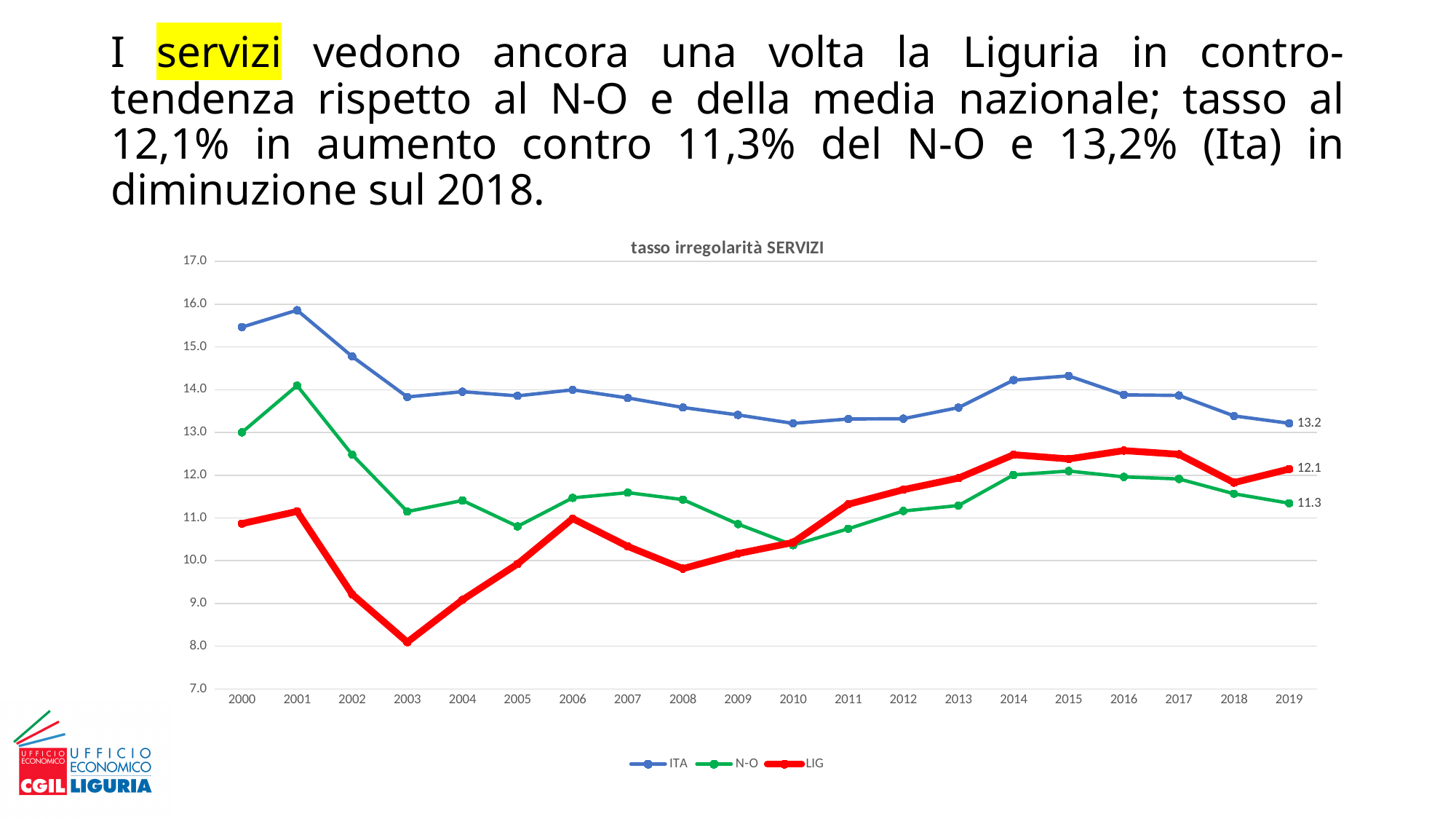
Is the value for LIG in 2003 greater or less than 9.0? less What is the difference between the ITA and LIG values in 2019? 1.1 How many series does the legend of the chart list? 3 How many years are shown on the x axis of the chart? 20 What is the title of the chart? tasso irregolarità SERVIZI What is the value for N-O in 2019? 11.3 What kind of chart is shown on the slide? line chart What is the value for LIG in 2019? 12.1 In which year does the LIG series reach its lowest value? 2003 Which series has the highest value in 2019? ITA Is the value for ITA in 2001 greater or less than 15.0? greater What is the value for ITA in 2019? 13.2